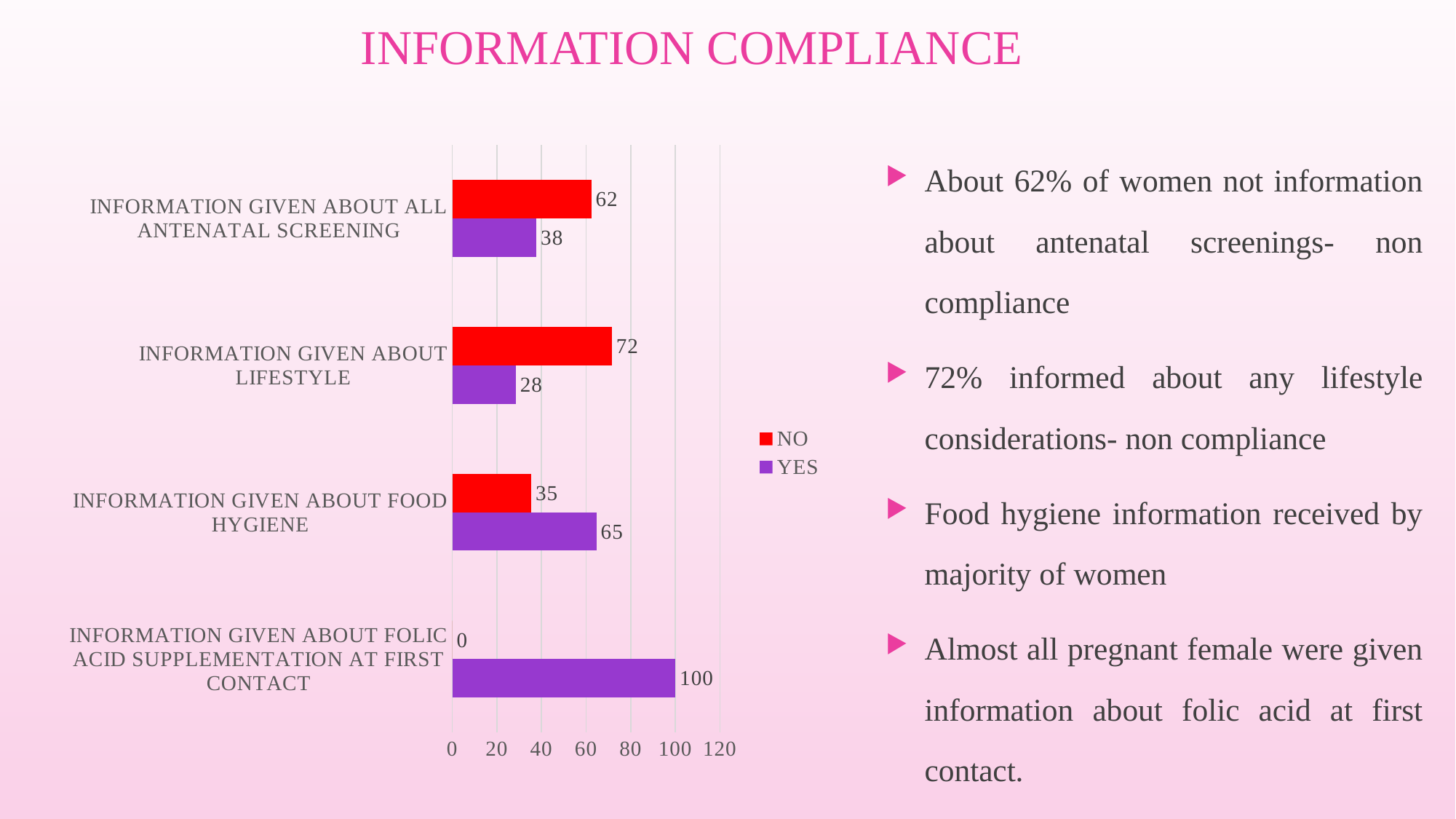
What is the YES value for information given about folic acid supplementation at first contact? 100 For information given about food hygiene, which is larger, the YES value or the NO value? YES What is the difference between the NO and YES values for information given about lifestyle? 44 How many categories are shown on the chart? 4 What is the NO value for information given about all antenatal screening? 62 How many series does the legend list? 2 What kind of chart is shown on the slide? Bar chart Which category has the lowest NO value? Information given about folic acid supplementation at first contact Which colour represents the NO series in the chart? Red Which category has the highest YES value? Information given about folic acid supplementation at first contact What is the YES value for information given about food hygiene? 65 What is the NO value for information given about lifestyle? 72